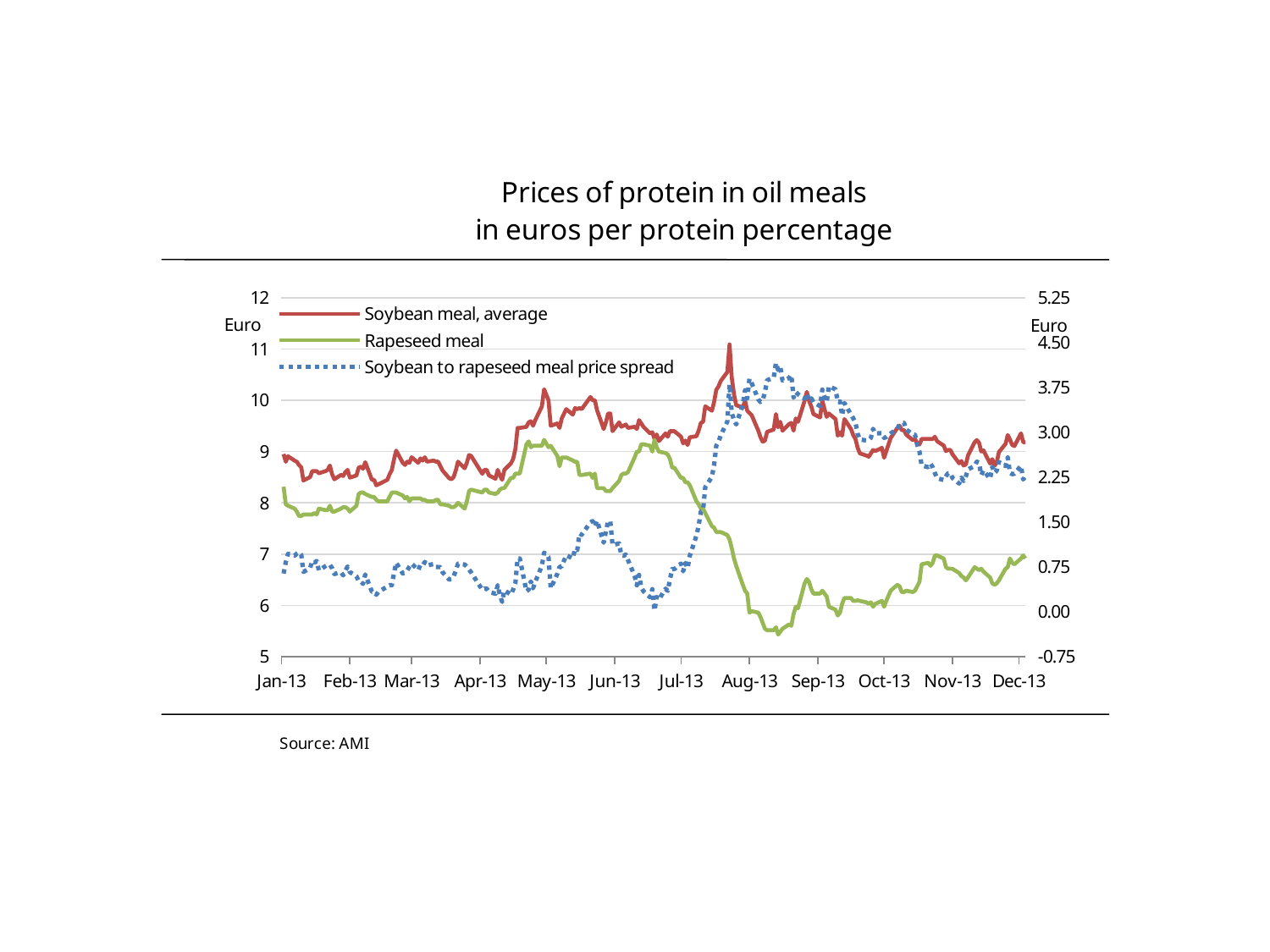
Is the value for Rapeseed meal in Aug-13 greater or less than 7? less In Jan-13, which is higher: Soybean meal, average or Rapeseed meal? Soybean meal, average What is the title of the chart? Prices of protein in oil meals in euros per protein percentage Does the Rapeseed meal line rise or fall between Jun-13 and Aug-13? fall What kind of chart is shown on the slide? line chart Which series is drawn with a dotted line? Soybean to rapeseed meal price spread Is the value for Rapeseed meal in Dec-13 greater or less than 8? less Is the value for Soybean meal, average in Jan-13 greater or less than 8? greater How many series does the legend list? 3